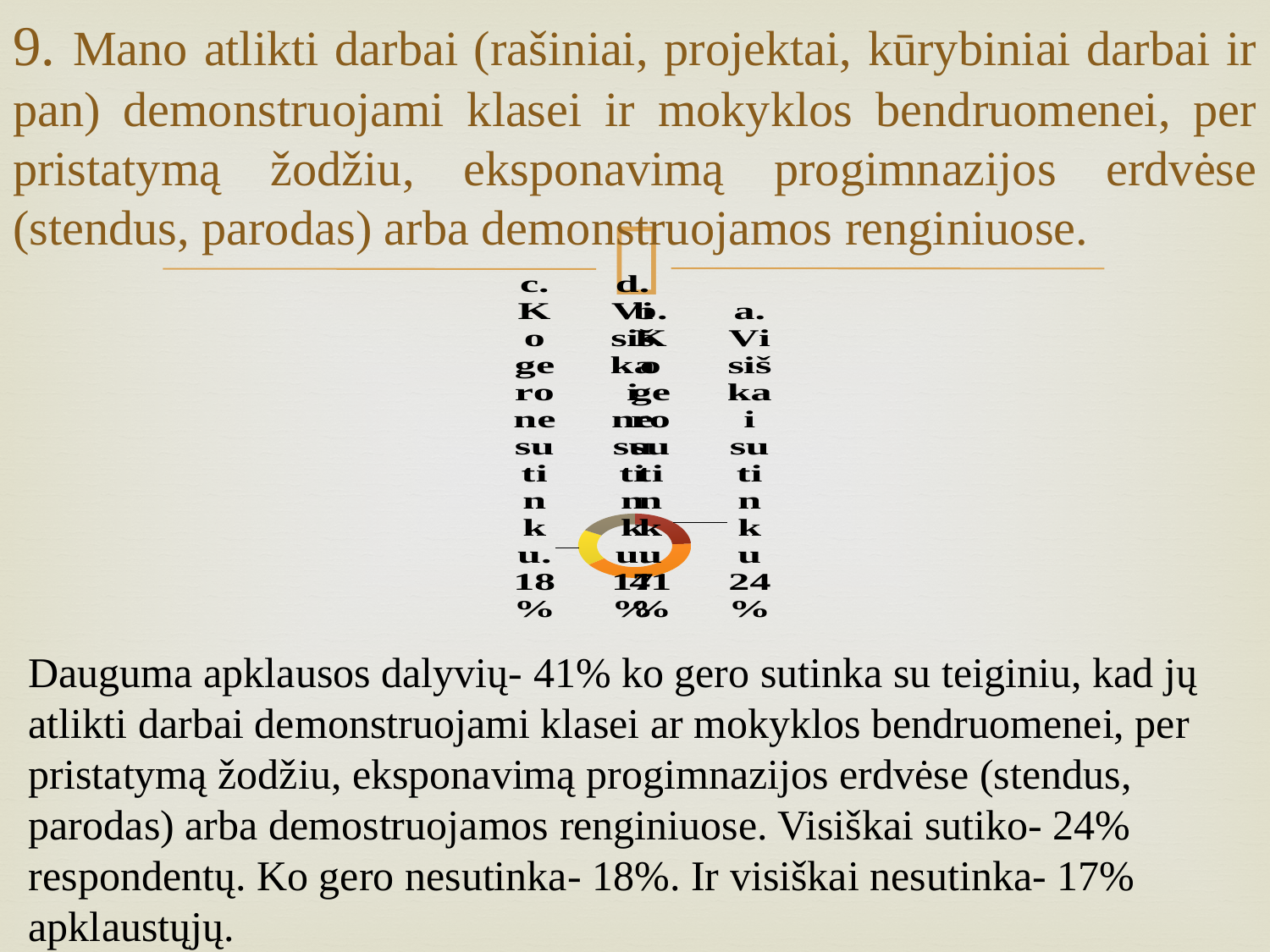
Which is larger, the share for "a. Visiškai sutinku" or for "c. Ko gero nesutinku"? a. Visiškai sutinku How many slices does the chart have? 4 What kind of chart is shown on the slide? doughnut (pie) chart What percentage is shown for "c. Ko gero nesutinku"? 18% Which answer option has the smallest share in the chart? d. Visiškai nesutinku (17%) What percentage is shown for "a. Visiškai sutinku"? 24% What is the combined share of "a. Visiškai sutinku" (24%) and "b. Ko gero sutinku" (41%)? 65% What is the difference between the share for "a. Visiškai sutinku" (24%) and "c. Ko gero nesutinku" (18%)? 6 percentage points Is the share for "a. Visiškai sutinku" greater or less than 20%? greater Which answer option has the largest share in the chart? b. Ko gero sutinku (41%)